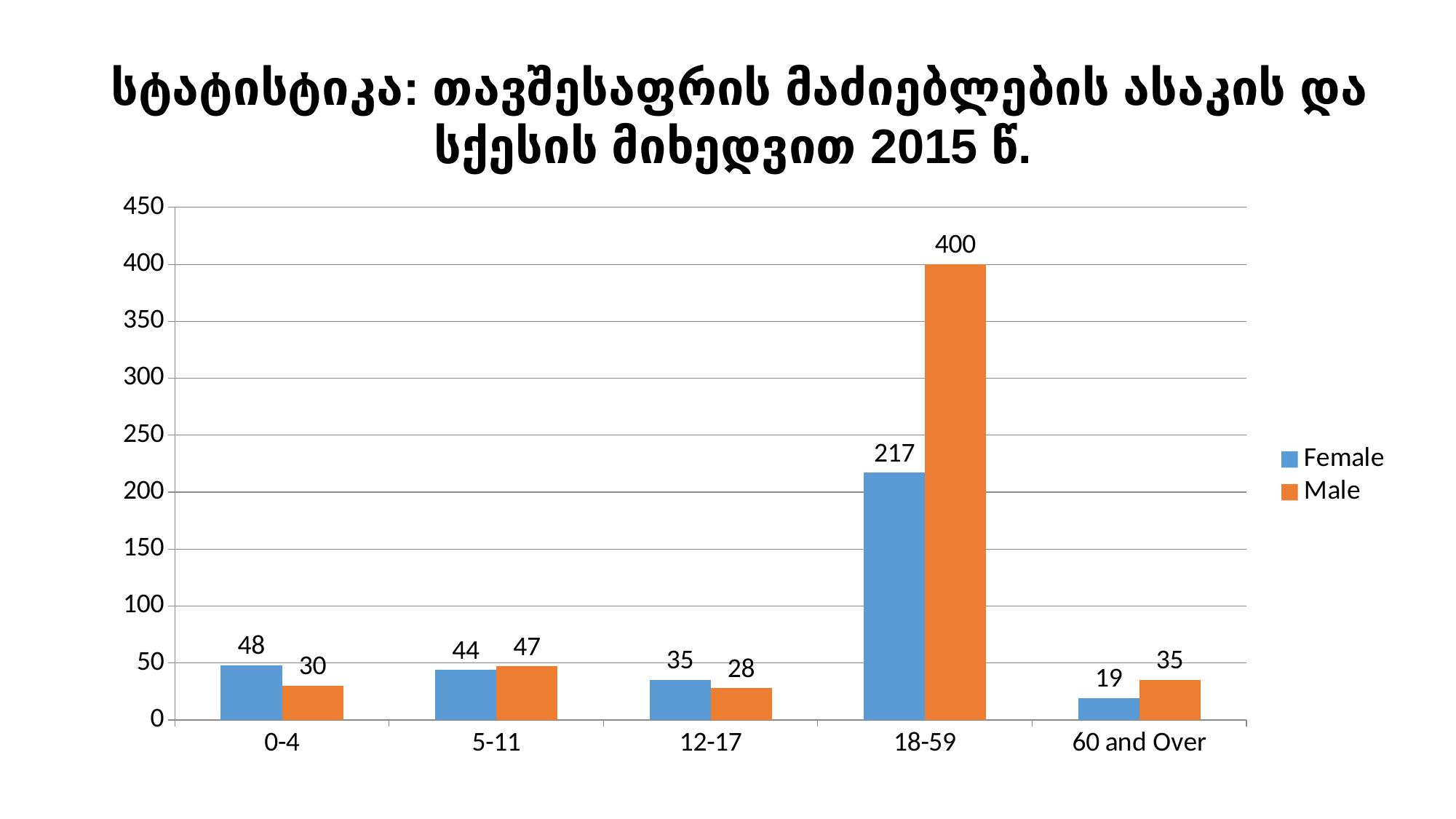
What is the difference between the Male and Female values for the 18-59 age group? 183 What is the Male value for the 0-4 age group? 30 How many series does the legend list? 2 Is the Male value for the 18-59 age group greater or less than 350? greater How many age groups are shown on the x axis? 5 Which age group has the lowest Female value? 60 and Over Which age group has the highest Male value? 18-59 What kind of chart is shown on the slide? bar chart Which colour represents the Male series? orange What is the Female value for the 60 and Over age group? 19 Which is larger for the 12-17 age group, the Female value or the Male value? Female What is the Female value for the 18-59 age group? 217